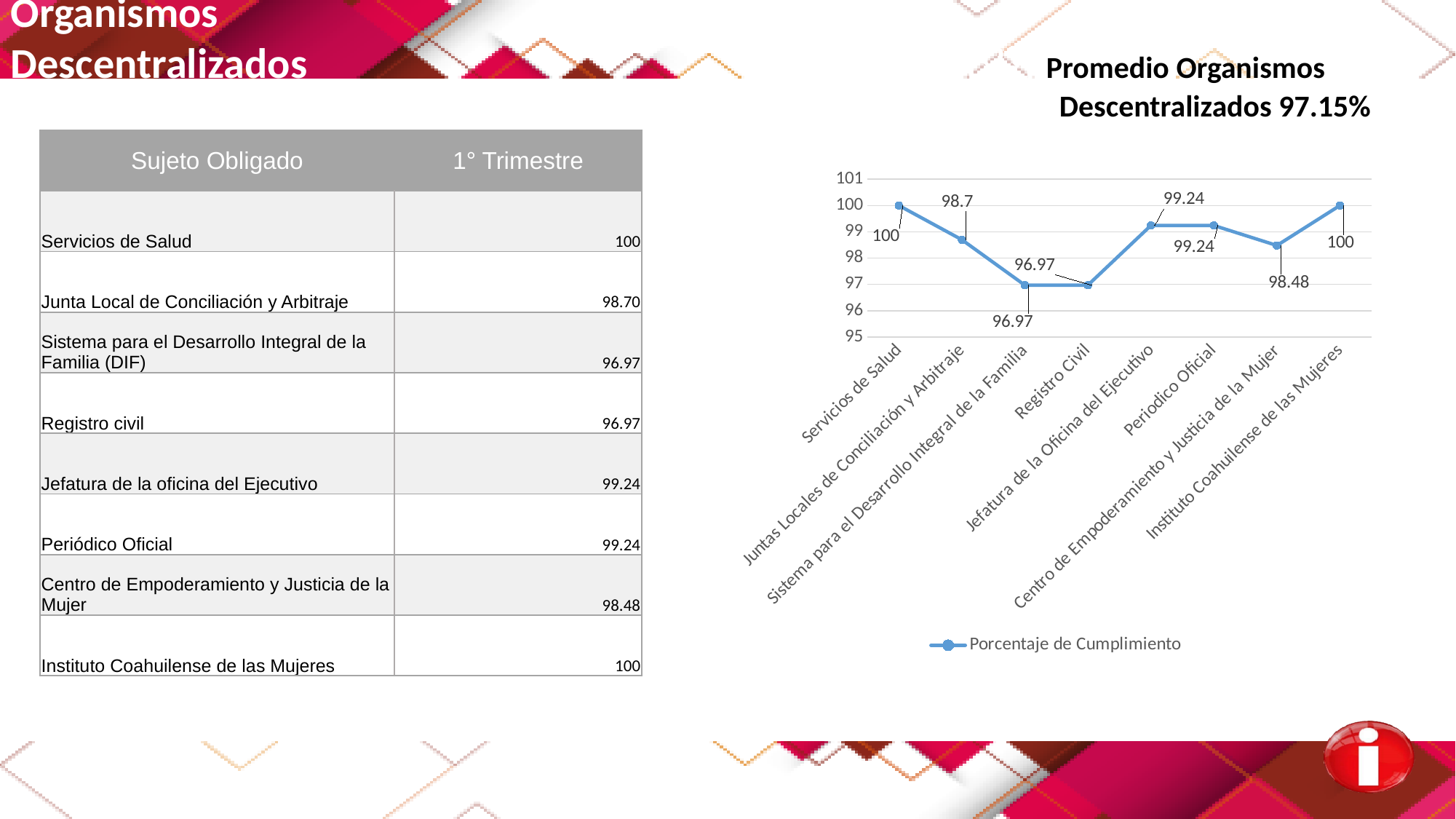
What is the value plotted for Servicios de Salud? 100 What is the highest value shown on the line chart? 100 What is the difference between the values for Jefatura de la Oficina del Ejecutivo and Sistema para el Desarrollo Integral de la Familia? 2.27 What is the value plotted for Juntas Locales de Conciliación y Arbitraje? 98.7 What is the value plotted for Centro de Empoderamiento y Justicia de la Mujer? 98.48 What kind of chart is shown on the slide? line chart How many categories are plotted on the x axis of the line chart? 8 How many series does the chart legend list? 1 What is the lowest value shown on the line chart? 96.97 Is the value for Registro Civil greater or less than 98? less What is the value plotted for Periodico Oficial? 99.24 Which has a larger value, Periodico Oficial or Centro de Empoderamiento y Justicia de la Mujer? Periodico Oficial